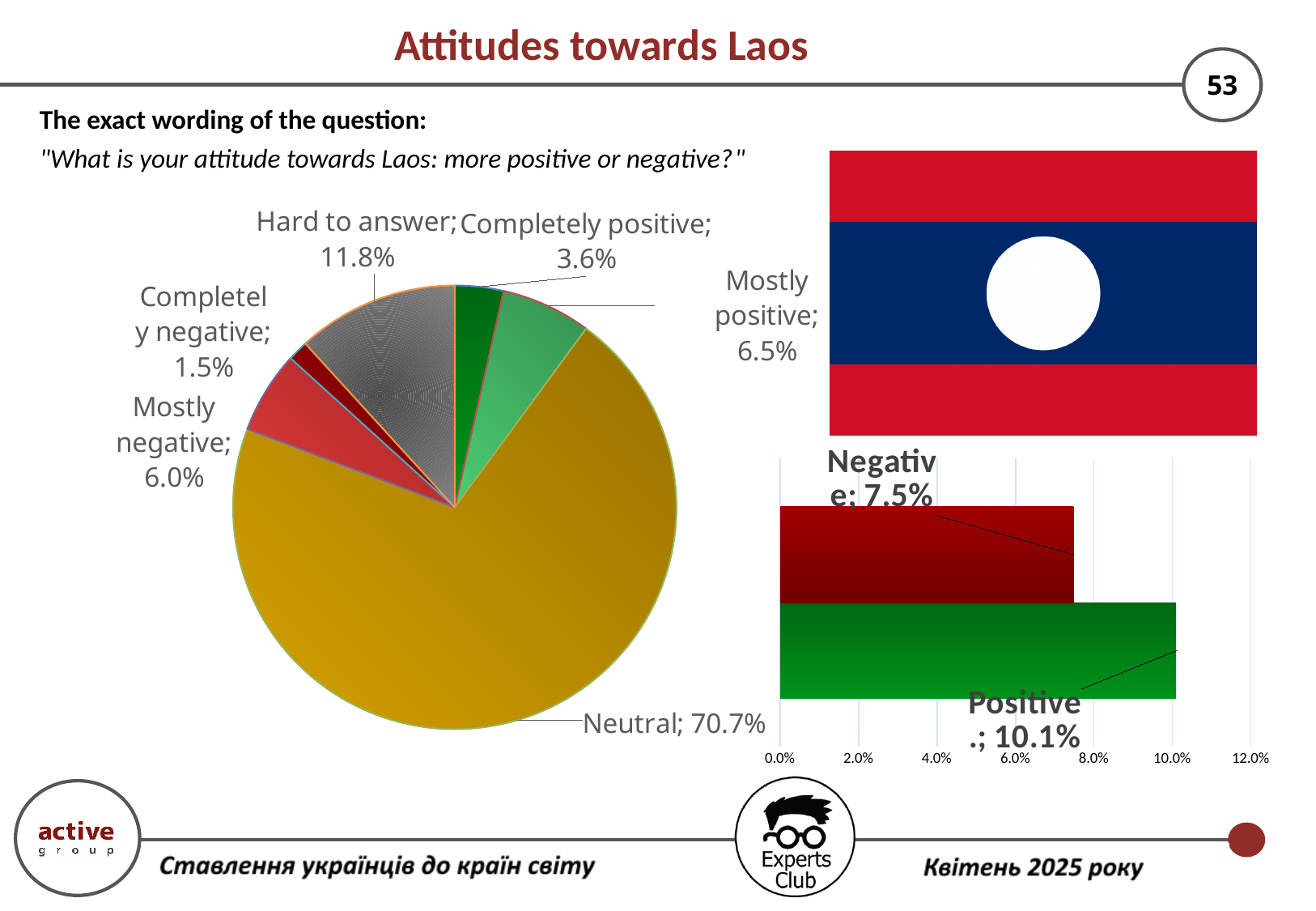
In the pie chart, what is the difference between Mostly positive and Completely positive? 2.9% What type of chart is shown at the bottom right of the slide? Bar chart In the pie chart, which category has the smallest slice? Completely negative In the bar chart, which is larger, Positive or Negative? Positive In the pie chart, how many slices are there? 6 In the pie chart, what share of respondents answered Neutral? 70.7% In the pie chart, what is the value for Hard to answer? 11.8% In the bar chart, what is the value for Negative? 7.5% In the pie chart, what is the value for Mostly positive? 6.5% In the bar chart, what is the value for Positive? 10.1% In the pie chart, which category has the largest slice? Neutral In the pie chart, what is the value for Completely negative? 1.5%